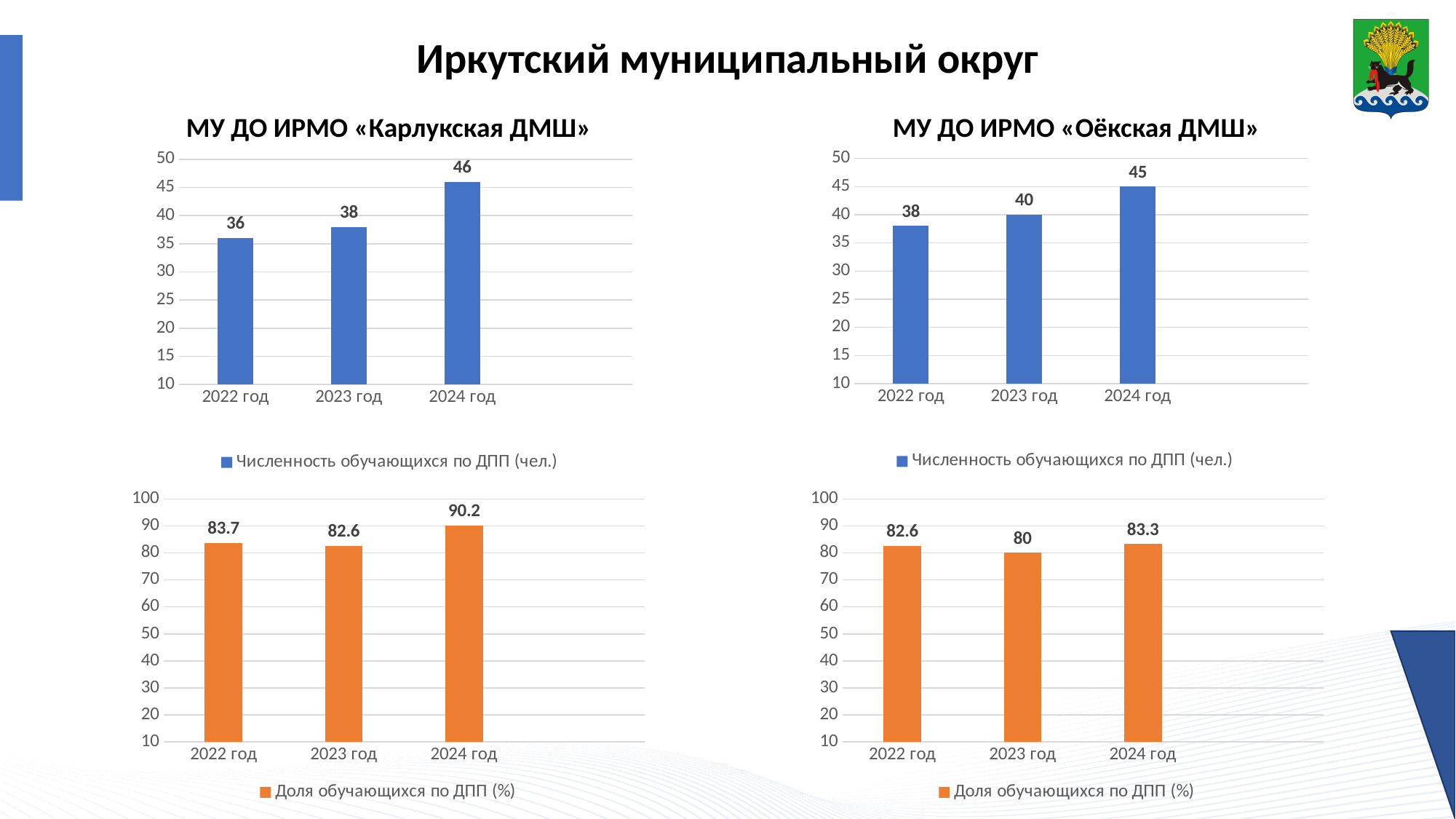
In the bottom-left chart (Доля обучающихся по ДПП (%), under Карлукская ДМШ), what is the value for 2023 год? 82.6 In the top-right chart titled «МУ ДО ИРМО «Оёкская ДМШ»», what is the value for 2023 год? 40 What type of chart is the bottom-right chart (Доля обучающихся по ДПП (%), under Оёкская ДМШ)? bar chart In the bottom-right chart (Доля обучающихся по ДПП (%), under Оёкская ДМШ), what is the value for 2024 год? 83.3 In the top-right chart titled «МУ ДО ИРМО «Оёкская ДМШ»», what is the difference between the values for 2024 год and 2022 год? 7 In the top-left chart titled «МУ ДО ИРМО «Карлукская ДМШ»», what is the value for 2024 год? 46 In the top-right chart titled «МУ ДО ИРМО «Оёкская ДМШ»», do the values rise or fall from 2022 год to 2024 год? rise In the top-left chart titled «МУ ДО ИРМО «Карлукская ДМШ»», which year has the highest value? 2024 год In the top-left chart titled «МУ ДО ИРМО «Карлукская ДМШ»», which is larger: the value for 2022 год or 2023 год? 2023 год How many years are shown on the x axis of the top-left chart titled «МУ ДО ИРМО «Карлукская ДМШ»»? 3 In the bottom-right chart (Доля обучающихся по ДПП (%), under Оёкская ДМШ), which year has the lowest value? 2023 год In the bottom-left chart (Доля обучающихся по ДПП (%), under Карлукская ДМШ), what is the difference between the values for 2024 год and 2023 год? 7.6